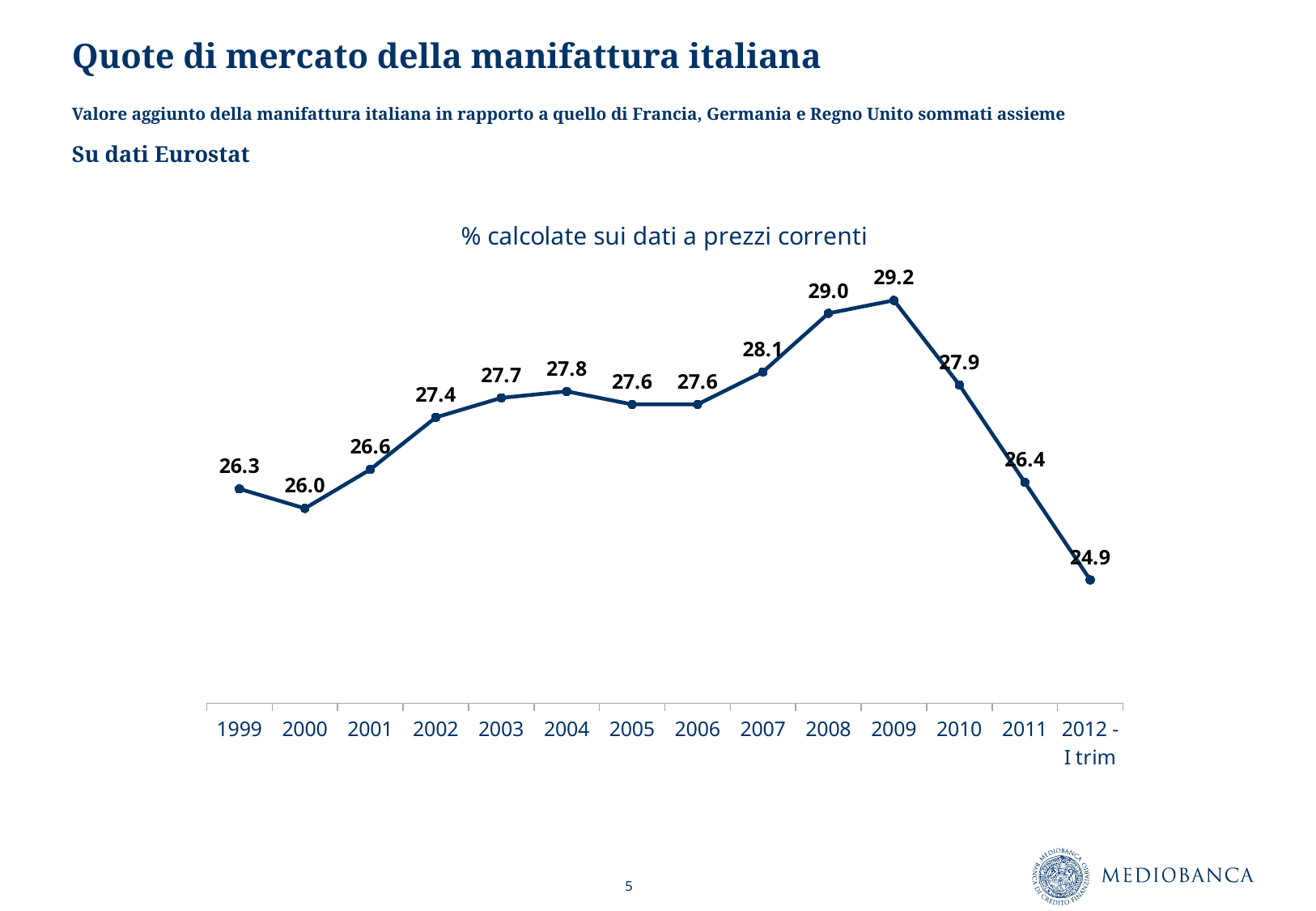
What is the difference between the values for 2009 and 2012 - I trim? 4.3 What is the value for 2009? 29.2 What is the difference between the values for 2008 and 2007? 0.9 What is the value for 2012 - I trim? 24.9 Which year has the highest value? 2009 Which point has the lowest value? 2012 - I trim What is the value for 2002? 27.4 Which is larger, the value for 2001 or the value for 2011? 2001 What kind of chart is shown? Line chart What is the title shown above the chart? % calcolate sui dati a prezzi correnti How many data points are plotted on the chart? 14 Do the values rise or fall from 2009 to 2012 - I trim? Fall